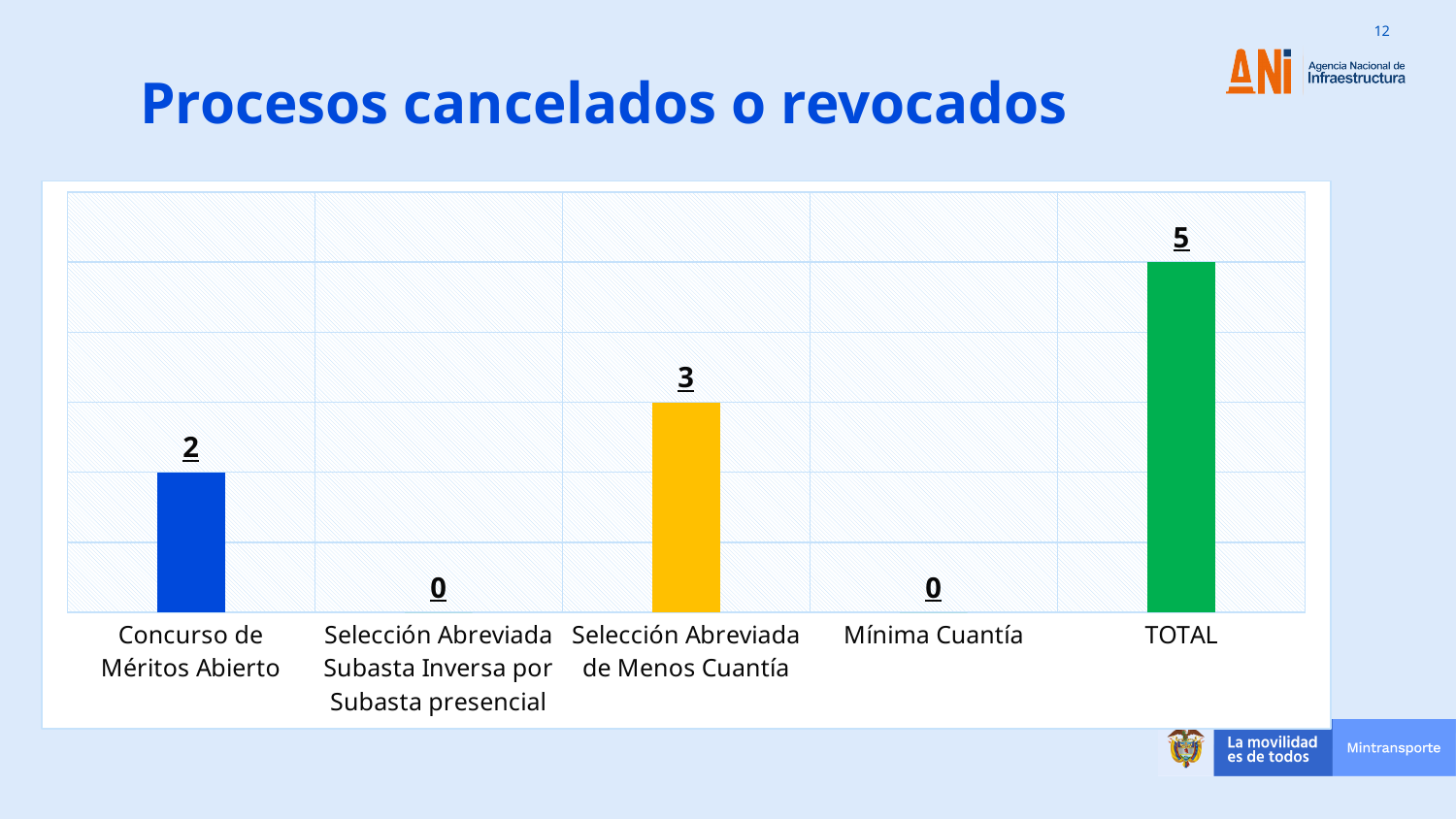
What is the value for Selección Abreviada de Menos Cuantía? 3 Which is larger, the value for Concurso de Méritos Abierto or the value for Selección Abreviada de Menos Cuantía? Selección Abreviada de Menos Cuantía What is the difference between the values for Selección Abreviada de Menos Cuantía and Concurso de Méritos Abierto? 1 What is the value for TOTAL? 5 What is the title of the slide containing the chart? Procesos cancelados o revocados What colour is the bar for TOTAL? Green Which category has the highest value? TOTAL How many categories are shown on the x axis? 5 What is the value for Mínima Cuantía? 0 What kind of chart is shown on the slide? Bar chart What is the value for Selección Abreviada Subasta Inversa por Subasta presencial? 0 What is the value for Concurso de Méritos Abierto? 2